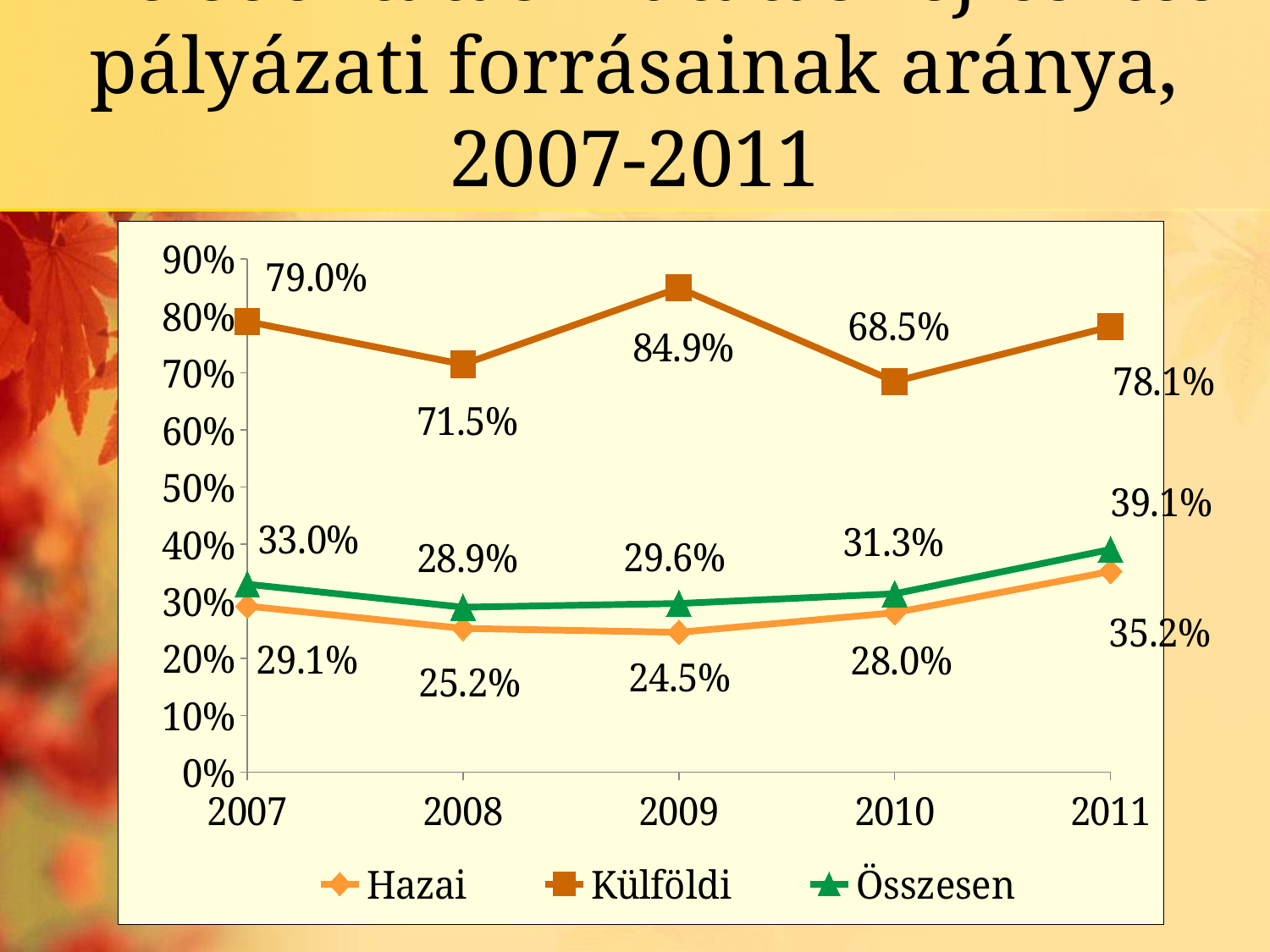
What is the value for Hazai in 2008? 25.2% In which year is the Külföldi value highest? 2009 How many years are shown on the x axis? 5 What is the difference between the Külföldi and Hazai values in 2007? 49.9% Which is larger in 2010, the Összesen value or the Hazai value? Összesen What is the value for Külföldi in 2010? 68.5% Is the value for Külföldi in 2008 greater or less than 70%? greater What kind of chart is shown on the slide? line chart What is the value for Külföldi in 2009? 84.9% In which year is the Hazai value lowest? 2009 What is the value for Összesen in 2011? 39.1% How many series does the legend list? 3